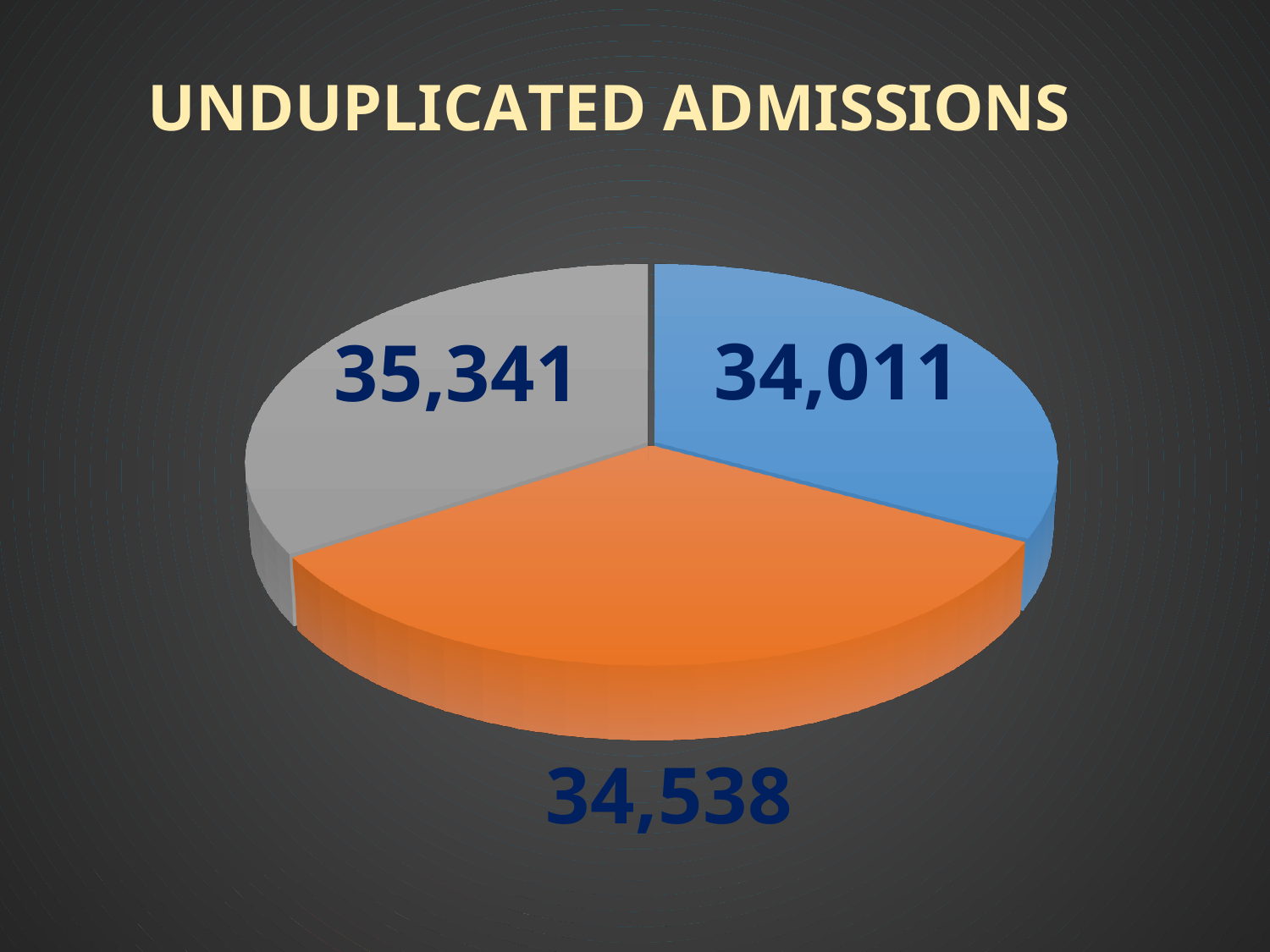
Which slice of the pie chart has the lowest value? The blue slice (34,011) What kind of chart is shown on the slide? Pie chart What value is shown on the gray slice of the pie chart? 35,341 What value is shown on the blue slice of the pie chart? 34,011 What is the total of all three values shown on the pie chart? 103,890 What is the difference between the gray slice value and the blue slice value? 1,330 How many slices does the pie chart have? 3 What is the difference between the orange slice value and the blue slice value? 527 Which is larger, the value on the orange slice or the value on the blue slice? The orange slice (34,538) What is the title of the chart? UNDUPLICATED ADMISSIONS Which slice of the pie chart has the highest value? The gray slice (35,341) What value is shown on the orange slice of the pie chart? 34,538